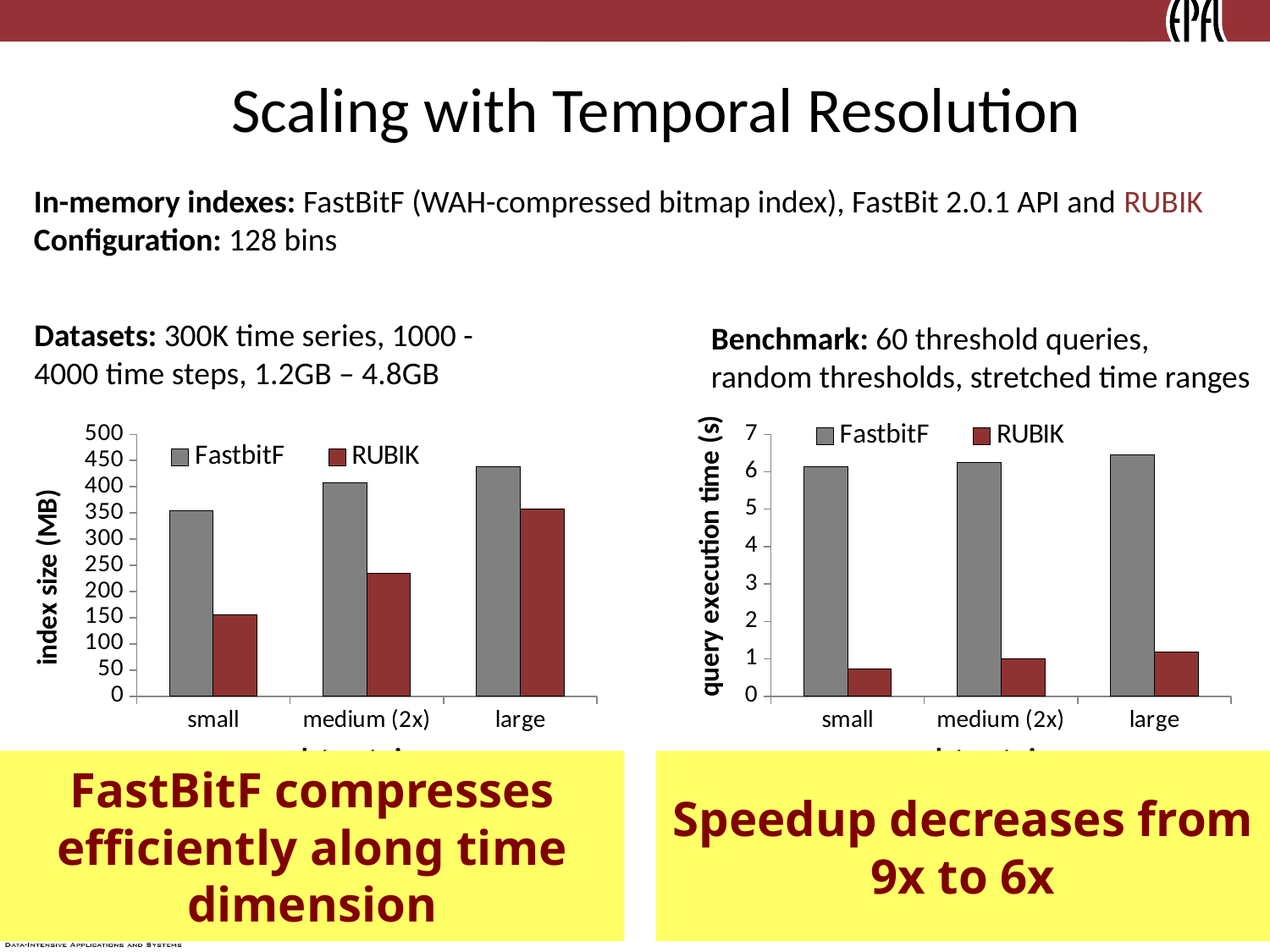
In the left chart (index size), is the RUBIK value for small greater or less than 200? less In the left chart (index size), which series has the larger value for medium (2x), FastbitF or RUBIK? FastbitF In the left chart (index size), do the RUBIK values rise or fall from small to large? rise In the left chart (index size), is the FastbitF value for small greater or less than 300? greater What kind of chart is the left chart (index size)? bar chart In the right chart (query execution time), which category has the highest RUBIK value? large In the right chart (query execution time), is the RUBIK value for small greater or less than 1? less In the left chart (index size), which category has the lowest RUBIK value? small How many series does the legend of the left chart (index size) list? 2 How many categories are shown on the x axis of the right chart (query execution time)? 3 What is the y-axis label of the right chart? query execution time (s)